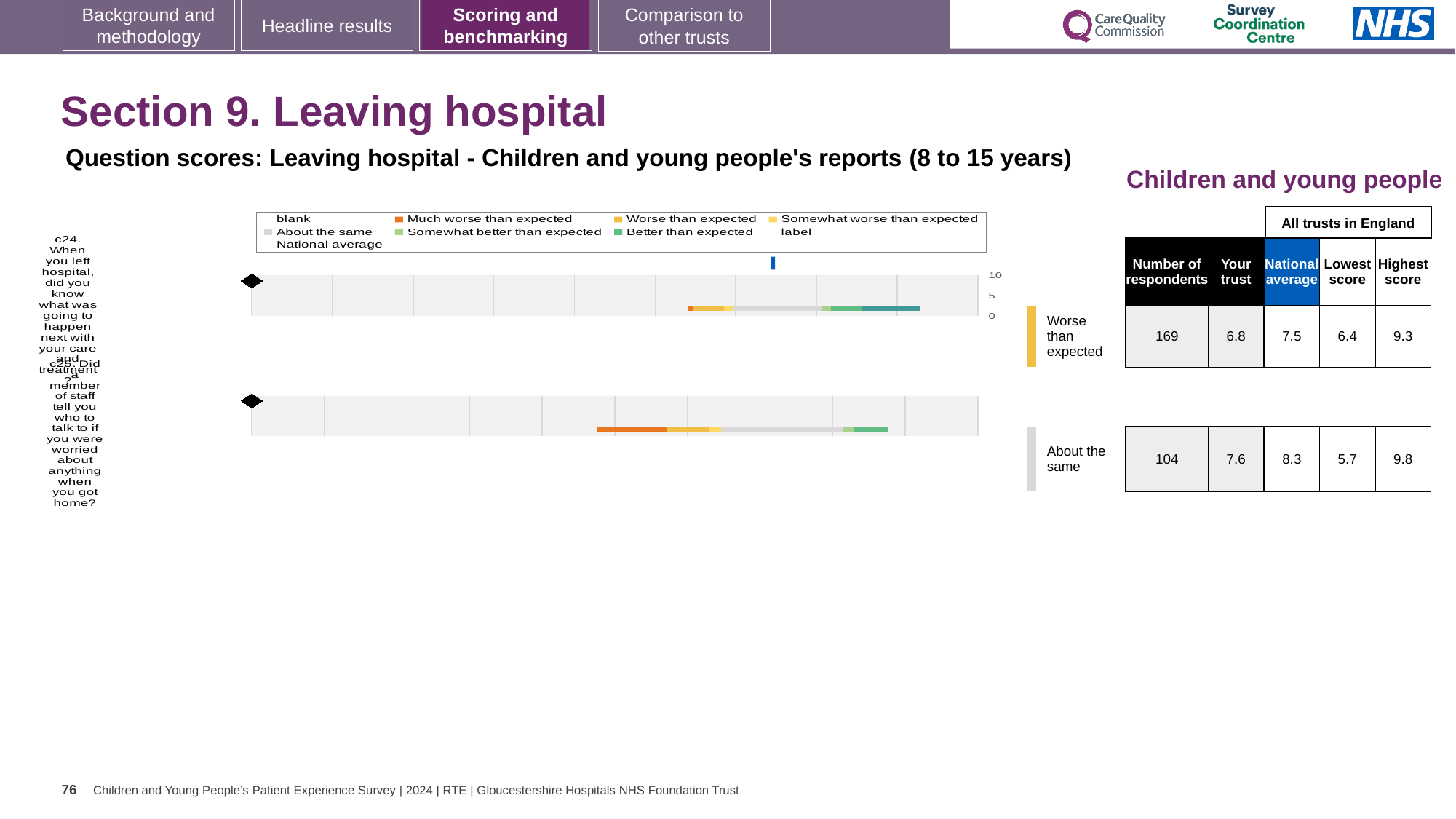
Which is higher for question c24: the trust's score or the national average? national average What benchmark category is question c24 rated as? Worse than expected What is the 'Your trust' score for question c24 (When you left hospital, did you know what was going to happen next with your care and treatment?)? 6.8 What is the highest score among all trusts in England for question c25? 9.8 How many questions are plotted in the Leaving hospital chart? 2 What is the national average score for question c24? 7.5 What is the lowest score among all trusts in England for question c24? 6.4 What is the 'Your trust' score for question c25 (Did a member of staff tell you who to talk to if you were worried about anything when you got home?)? 7.6 How many respondents answered question c24? 169 What is the difference between the national average and the trust's score for question c25? 0.7 What benchmark category is question c25 rated as? About the same What kind of chart is used to show the question scores for Leaving hospital? bar chart